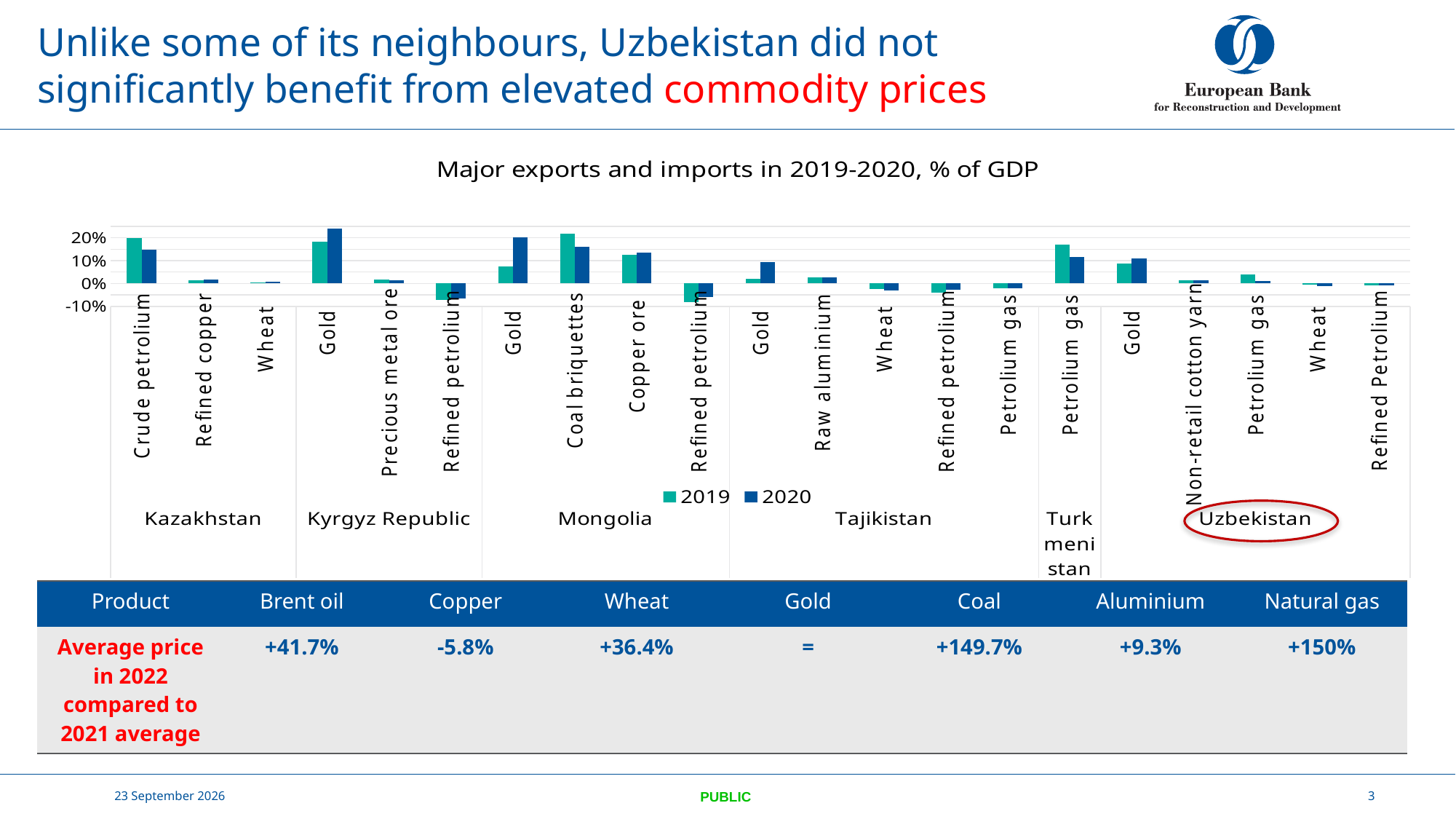
For Gold in the Kyrgyz Republic, which year has the larger value, 2019 or 2020? 2020 Within the Uzbekistan group, which product has the highest value? Gold What kind of chart is shown on the slide? bar chart What is the title of the chart? Major exports and imports in 2019-2020, % of GDP How many product categories are plotted on the chart in total? 21 Is the 2019 value for Refined petroleum in Mongolia greater or less than 0%? less Is the 2020 value for Gold in the Kyrgyz Republic greater or less than 20%? greater How many series does the chart legend list? 2 For Coal briquettes in Mongolia, which year has the larger value, 2019 or 2020? 2019 Is the 2019 value for Petrolium gas in Turkmenistan greater or less than 10%? greater How many countries are grouped along the x axis of the chart? 6